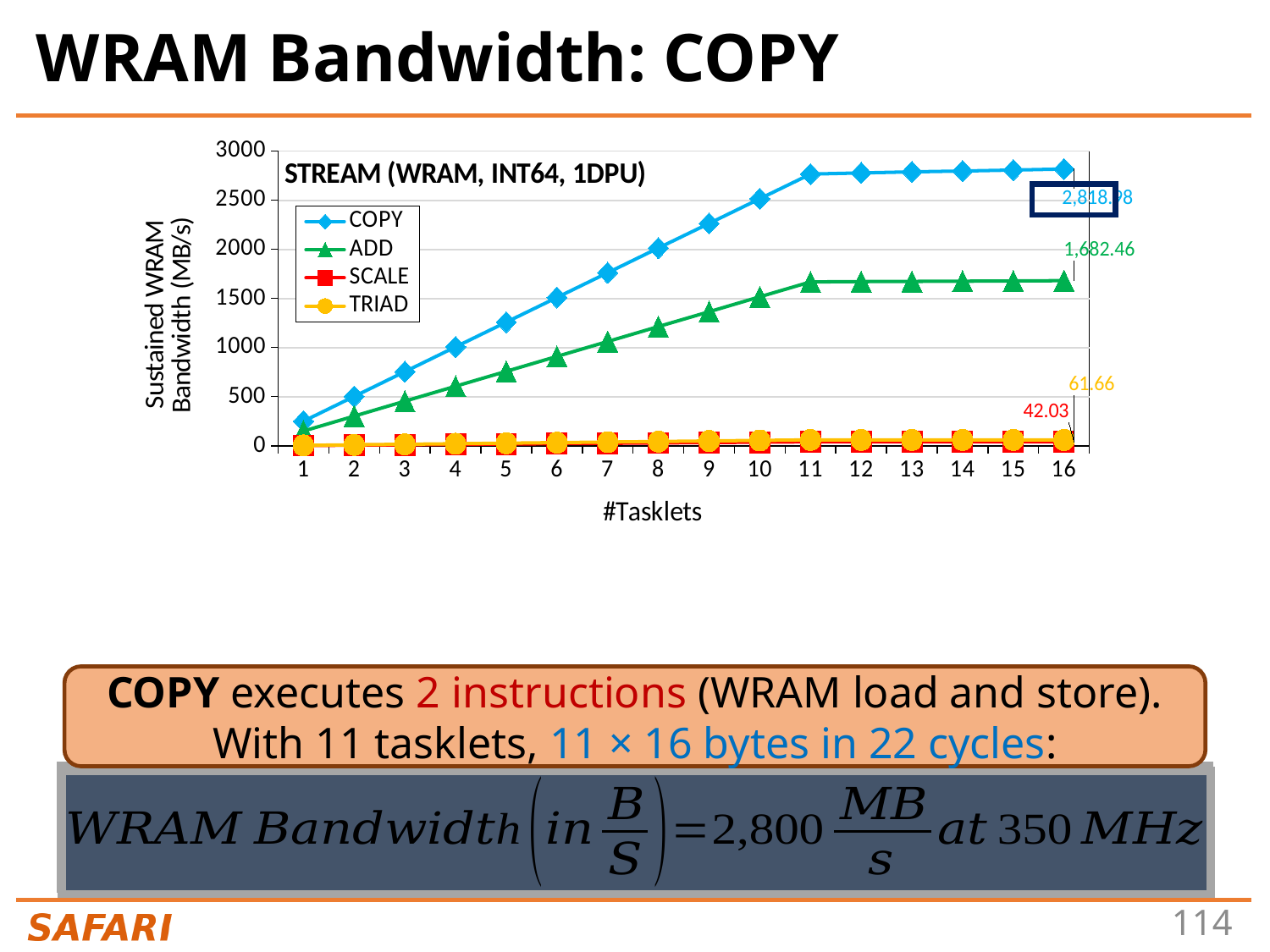
Which series has the highest bandwidth at 16 tasklets? COPY Does the COPY bandwidth rise or fall as tasklets increase from 1 to 11? rise What is the ADD bandwidth at 16 tasklets? 1,682.46 What is the difference between the TRIAD and SCALE bandwidths at 16 tasklets? 19.63 What is the TRIAD bandwidth at 16 tasklets? 61.66 Which series has the lowest bandwidth at 16 tasklets? SCALE Is the COPY bandwidth at 11 tasklets greater or less than 2500? greater What kind of chart is shown on the slide? line chart What is the SCALE bandwidth at 16 tasklets? 42.03 How many series does the legend list? 4 At 16 tasklets, which is larger: TRIAD or SCALE? TRIAD How many tasklet counts are plotted along the x axis? 16